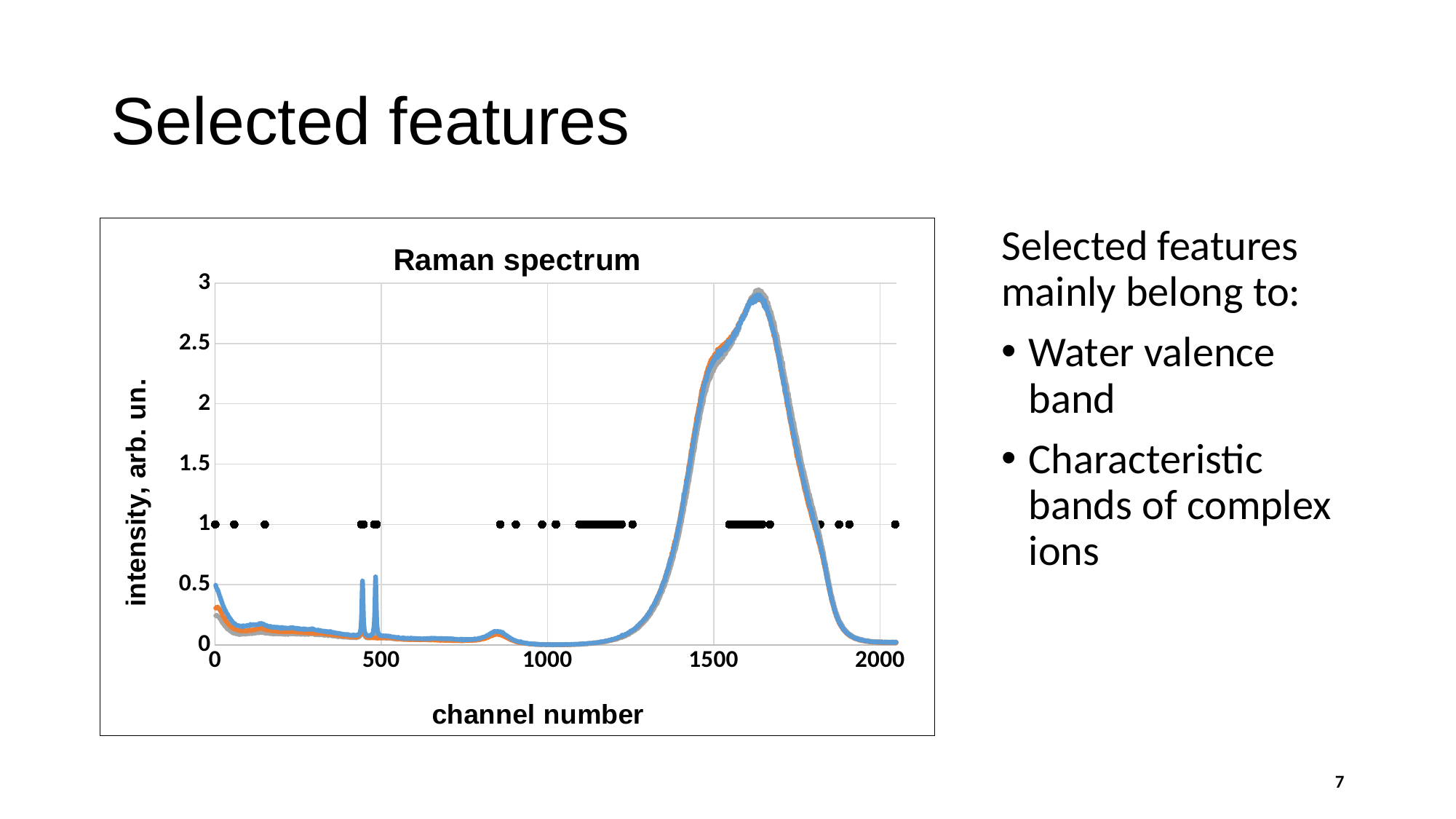
What is the highest value shown on the y axis of the Raman spectrum chart? 3 Does the intensity rise or fall as the channel number goes from 1700 to 2000? fall What is the label of the x axis of the Raman spectrum chart? channel number What kind of chart is the Raman spectrum? line chart Is the intensity at channel number 1500 greater or less than 2? greater What is the title of the chart? Raman spectrum Is the intensity at channel number 0 greater or less than 1? less Is the peak intensity of the Raman spectrum greater or less than 2.5? greater Does the intensity rise or fall as the channel number goes from 1000 to 1500? rise Is the intensity at channel number 1500 larger or smaller than the intensity at channel number 500? larger